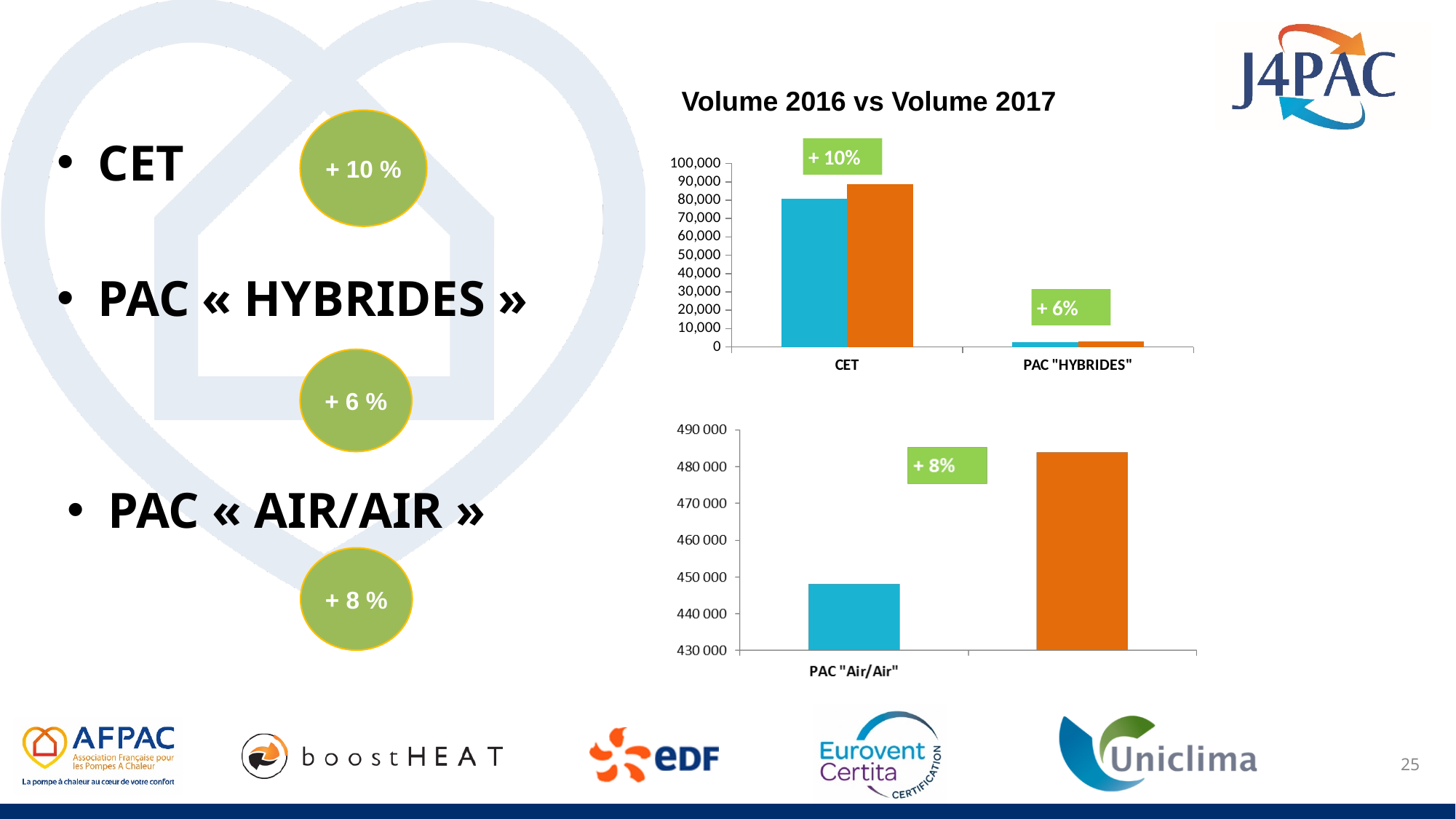
In the bottom chart, which bar is taller for PAC "Air/Air", the blue bar or the orange bar? the orange bar What is the title of the top chart? Volume 2016 vs Volume 2017 In the bottom chart, is the value of the orange PAC "Air/Air" bar greater or less than 480 000? greater In the top chart, which category has the highest bars, CET or PAC "HYBRIDES"? CET In the bottom chart, what percentage change label is shown for PAC "Air/Air"? + 8% In the top chart, what percentage change label is shown above the PAC "HYBRIDES" bars? + 6% In the top chart, how many categories are shown on the x axis? 2 In the top chart, is the value of the orange CET bar greater or less than 80,000? greater In the top chart, are the PAC "HYBRIDES" bars greater or less than 10,000? less What kind of chart is the top chart titled "Volume 2016 vs Volume 2017"? bar chart In the top chart, what percentage change label is shown above the CET bars? + 10%